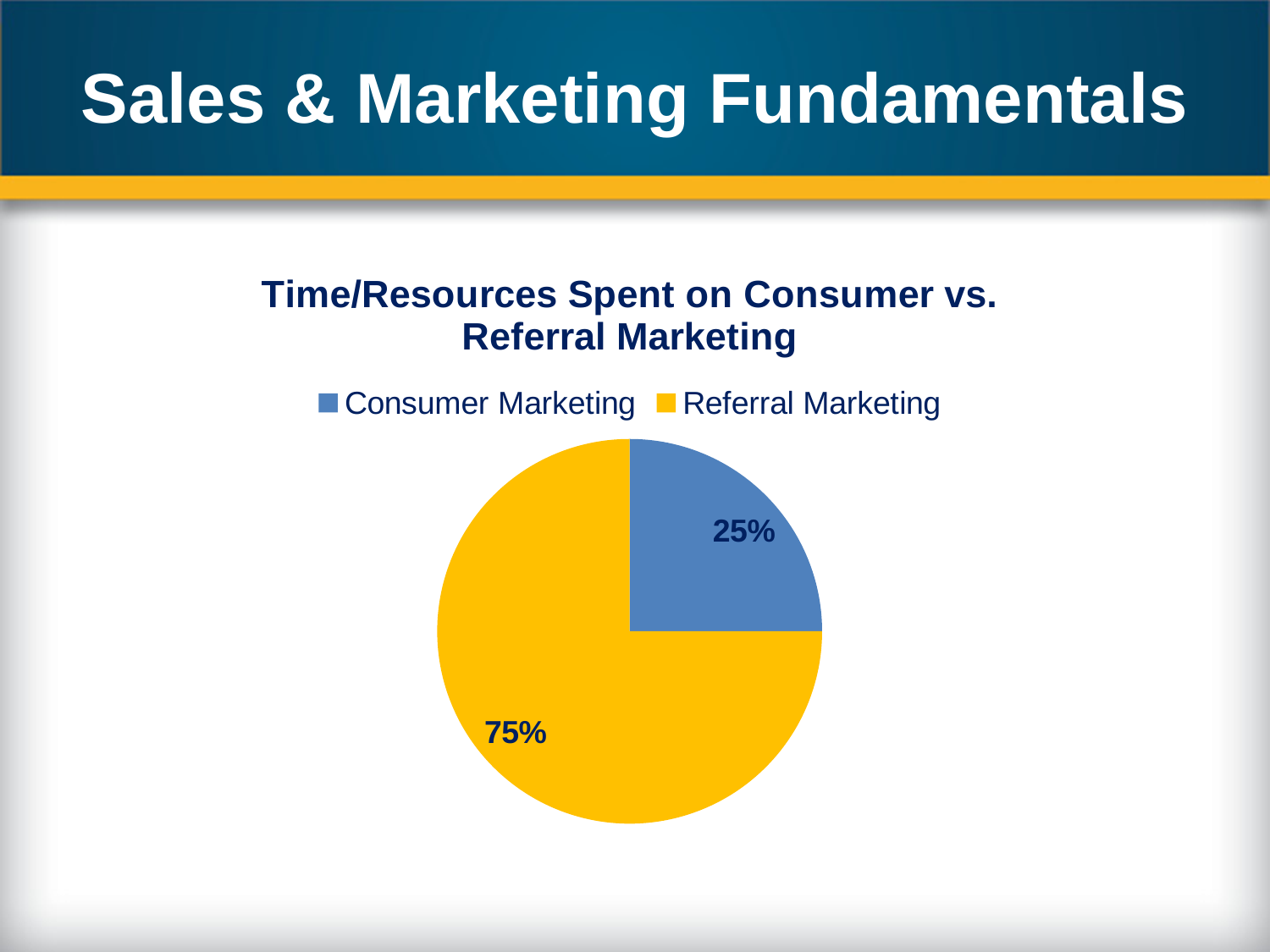
What is the difference in percentage points between Referral Marketing and Consumer Marketing? 50 Which is larger, the Consumer Marketing slice or the Referral Marketing slice? Referral Marketing What share of the pie does Referral Marketing represent? 75% What share of the pie does Consumer Marketing represent? 25% Which category has the largest slice of the pie? Referral Marketing How many slices does the pie chart have? 2 What is the title of the chart? Time/Resources Spent on Consumer vs. Referral Marketing What colour is the Referral Marketing slice? Yellow What kind of chart is shown on the slide? Pie chart What is the total of the two slices shown? 100% Which category has the smallest slice of the pie? Consumer Marketing